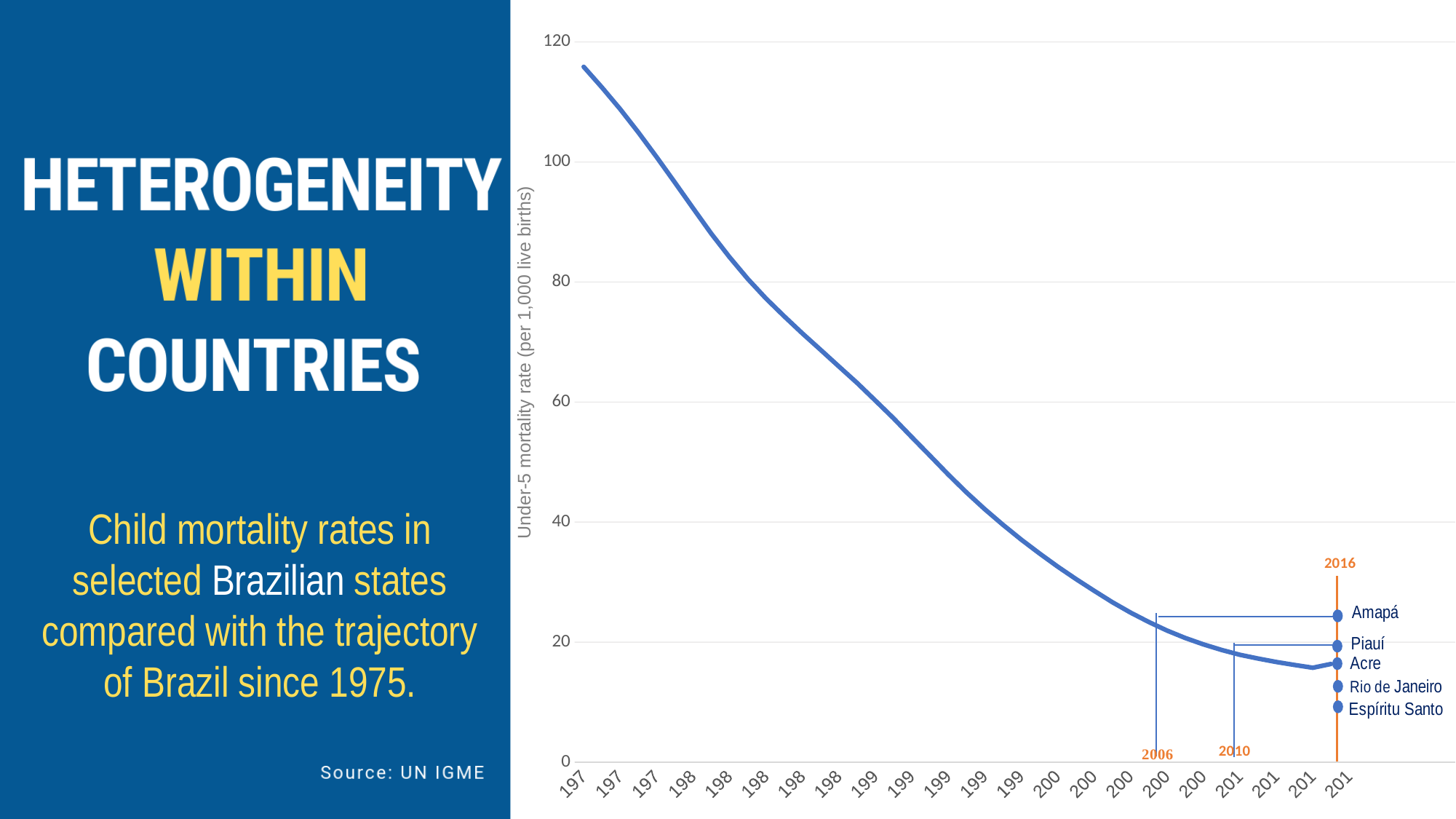
How many Brazilian states are labelled on the chart? 5 What is the label of the y axis? Under-5 mortality rate (per 1,000 live births) Is the value for Rio de Janeiro greater or less than 20? less Is the value for Amapá greater or less than 20? greater What kind of chart is shown on the slide? line chart Is the value of Brazil's under-5 mortality rate at the start of the line (1975) greater or less than 100? greater Does Brazil's under-5 mortality rate rise or fall over time along the x axis? fall Which three years are marked with orange labels on the chart? 2006, 2010, 2016 Which of the labelled Brazilian states has the highest under-5 mortality rate? Amapá Which of the labelled Brazilian states has the lowest under-5 mortality rate? Espíritu Santo Which has a higher under-5 mortality rate, Amapá or Espíritu Santo? Amapá